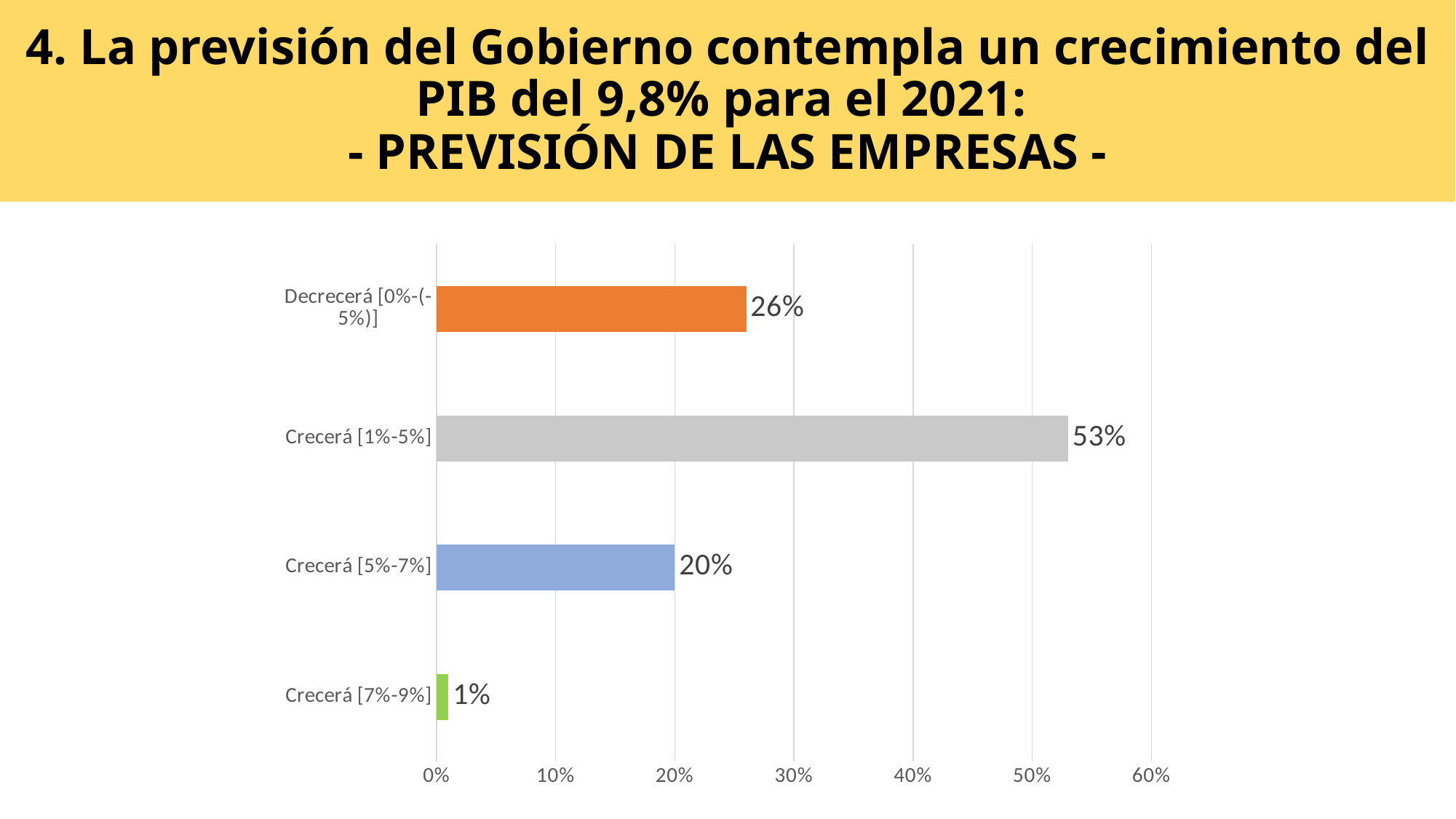
What is the value for Crecerá [5%-7%]? 20% Which category has the highest value? Crecerá [1%-5%] Is the value for Crecerá [1%-5%] greater or less than 50%? greater What is the difference between the values for Crecerá [1%-5%] and Decrecerá [0%-(-5%)]? 27% What is the value for Decrecerá [0%-(-5%)]? 26% What is the value for Crecerá [7%-9%]? 1% How many categories are shown in the chart? 4 Which category has the lowest value? Crecerá [7%-9%] What kind of chart is shown on the slide? bar chart Which is larger, the value for Decrecerá [0%-(-5%)] or the value for Crecerá [5%-7%]? Decrecerá [0%-(-5%)] What colour is the bar for Crecerá [7%-9%]? green What is the value for Crecerá [1%-5%]? 53%